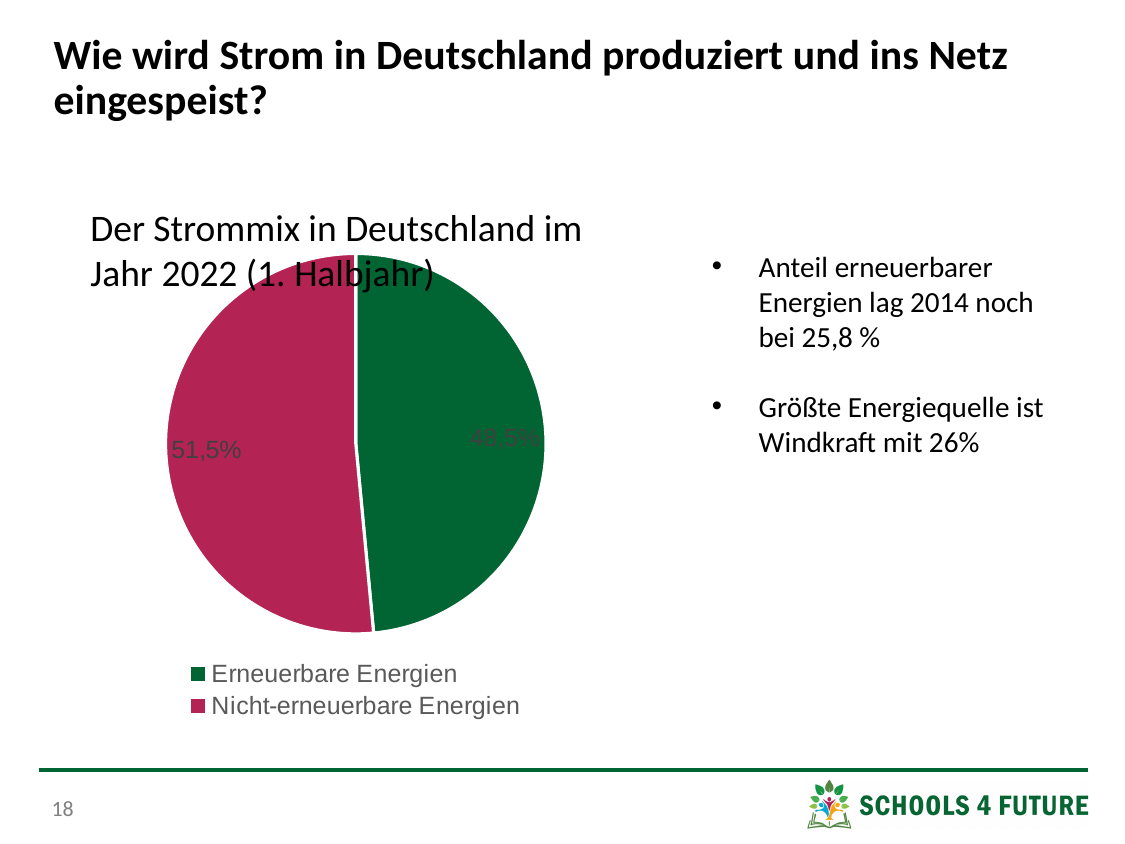
Which is larger, the share for Erneuerbare Energien or the share for Nicht-erneuerbare Energien? Nicht-erneuerbare Energien How many slices does the pie chart have? 2 Which slice of the pie is the largest? Nicht-erneuerbare Energien Which slice of the pie is the smallest? Erneuerbare Energien What share of the pie does Nicht-erneuerbare Energien have? 51,5% Which colour represents Erneuerbare Energien in the pie chart? green How many entries does the legend list? 2 What share of the pie does Erneuerbare Energien have? 48,5% What kind of chart is shown on the slide? pie chart What is the difference in percentage points between Nicht-erneuerbare Energien and Erneuerbare Energien? 3 percentage points What is the title of the pie chart? Der Strommix in Deutschland im Jahr 2022 (1. Halbjahr)